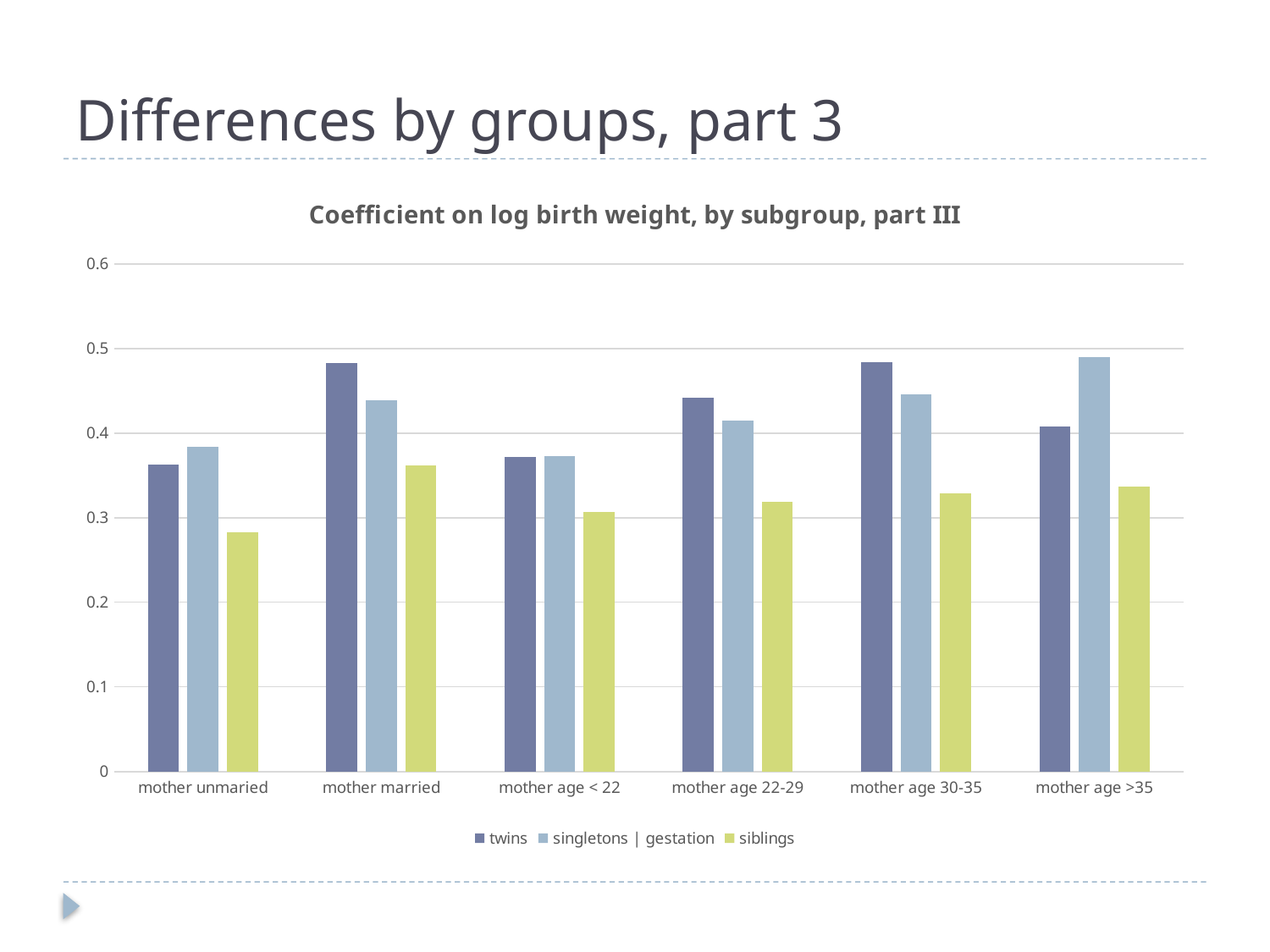
What kind of chart is shown on the slide? bar chart Is the siblings value for mother married greater or less than 0.3? greater Is the siblings value for mother unmaried greater or less than 0.3? less How many series does the legend list? 3 Which series is shown in yellow-green in the legend? siblings Is the singletons | gestation value for mother age >35 greater or less than 0.4? greater For which subgroup is the siblings value lowest? mother unmaried What is the title of the chart? Coefficient on log birth weight, by subgroup, part III How many subgroup categories are shown on the x axis? 6 For mother married, which is larger: twins or singletons | gestation? twins For mother age >35, which is larger: twins or singletons | gestation? singletons | gestation